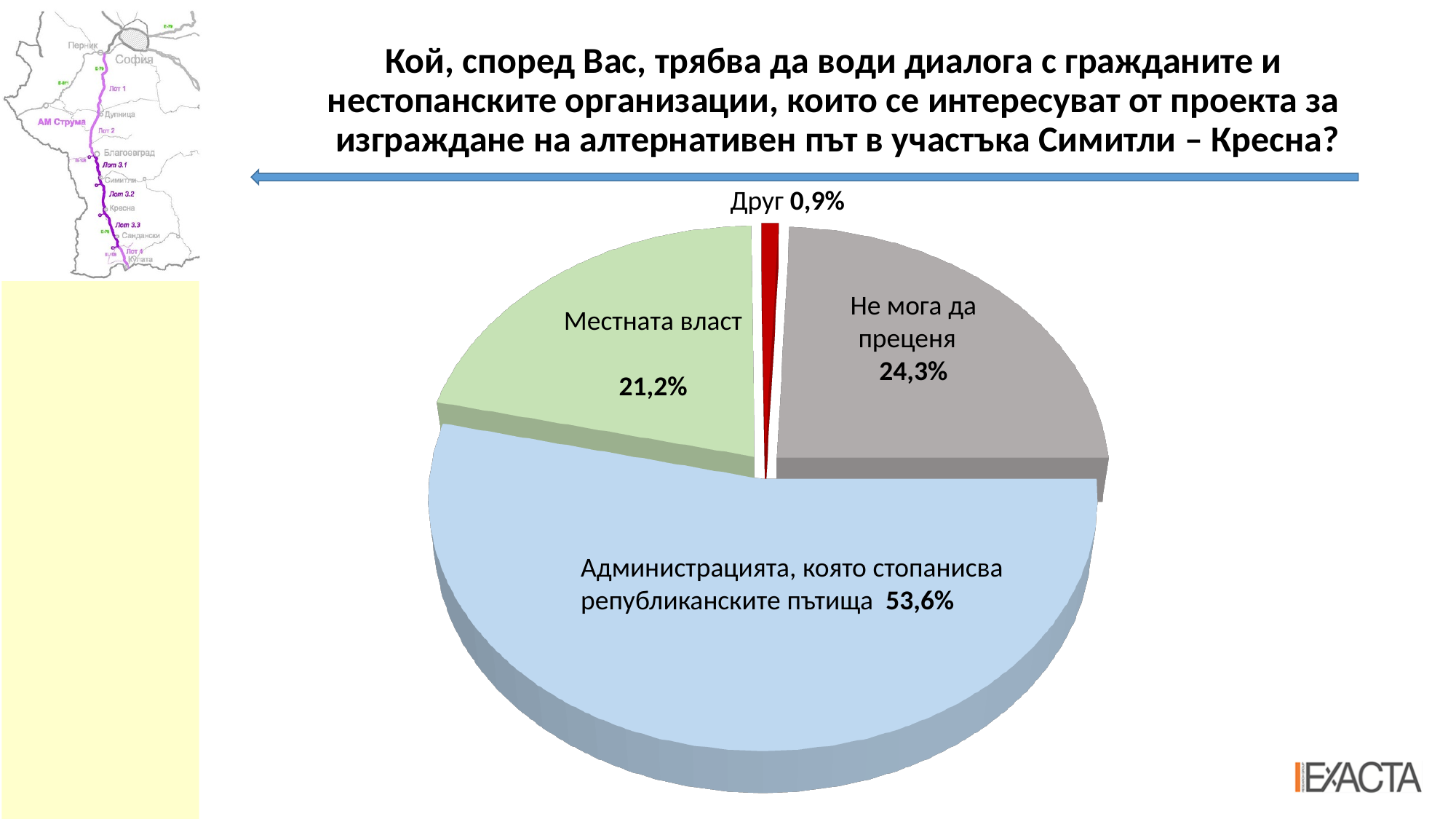
What is the value shown for "Местната власт"? 21,2% Which category has the largest slice of the pie? Администрацията, която стопанисва републиканските пътища What is the difference in percentage points between "Не мога да преценя" and "Местната власт"? 3,1 Which is larger: the slice for "Местната власт" or the slice for "Не мога да преценя"? Не мога да преценя What share of the pie does "Администрацията, която стопанисва републиканските пътища" hold? 53,6% What colour is the slice for "Друг"? Red What is the value shown for "Друг"? 0,9% How many categories are shown in the pie chart? 4 What is the difference in percentage points between "Администрацията, която стопанисва републиканските пътища" and "Не мога да преценя"? 29,3 Which category has the smallest slice of the pie? Друг What kind of chart is shown on the slide? Pie chart What is the value shown for "Не мога да преценя"? 24,3%